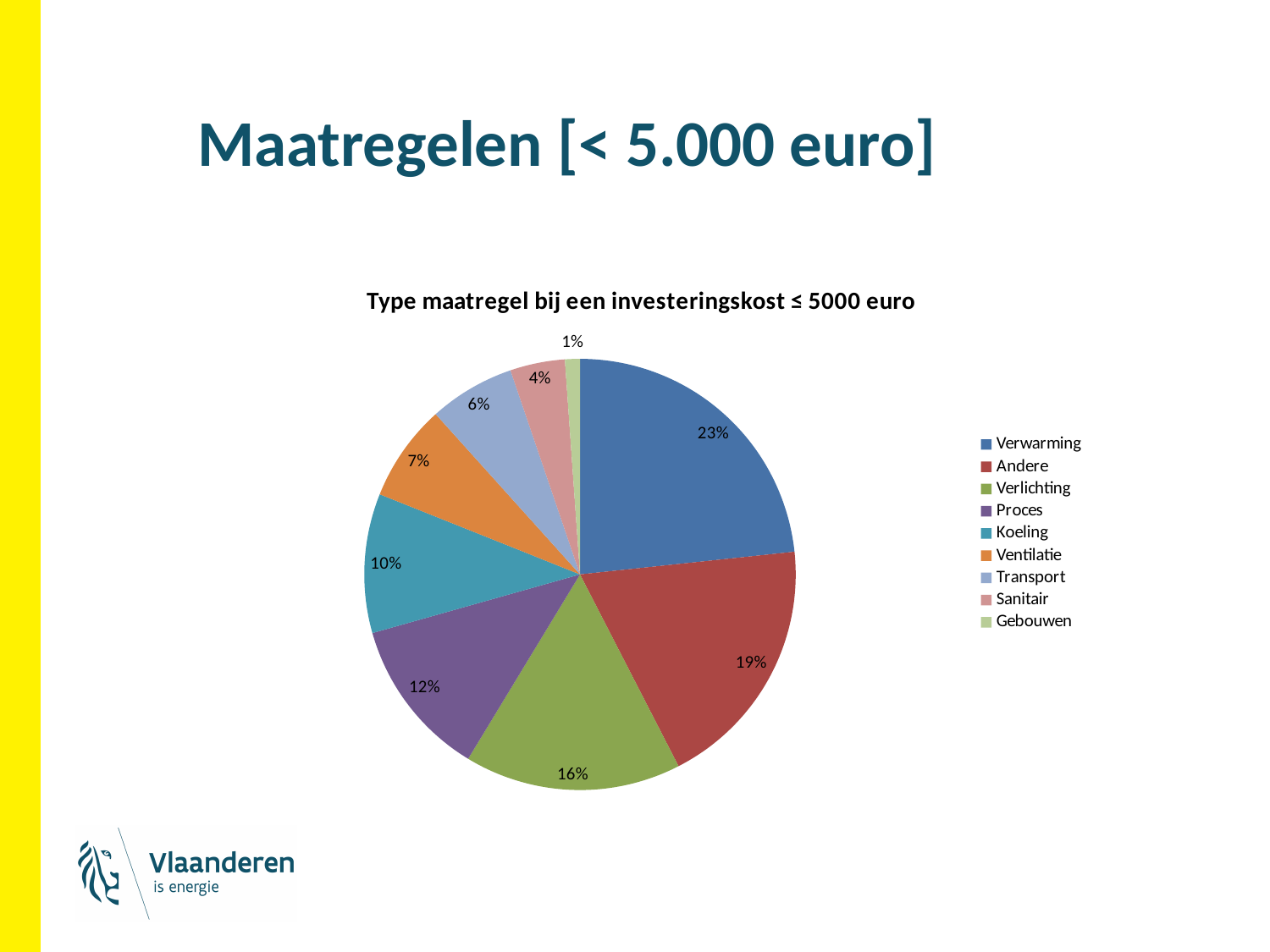
What share of the pie does Verwarming have? 23% Which category has the smallest slice of the pie? Gebouwen Which category has the largest slice of the pie? Verwarming What is the chart's title? Type maatregel bij een investeringskost ≤ 5000 euro How many categories does the legend list? 9 What is the difference in percentage points between Andere and Proces? 7 Which is larger, the slice for Ventilatie or the slice for Transport? Ventilatie What kind of chart is shown on the slide? pie chart What share of the pie does Sanitair have? 4% What share of the pie does Koeling have? 10% What is the combined share of Verwarming and Andere? 42%